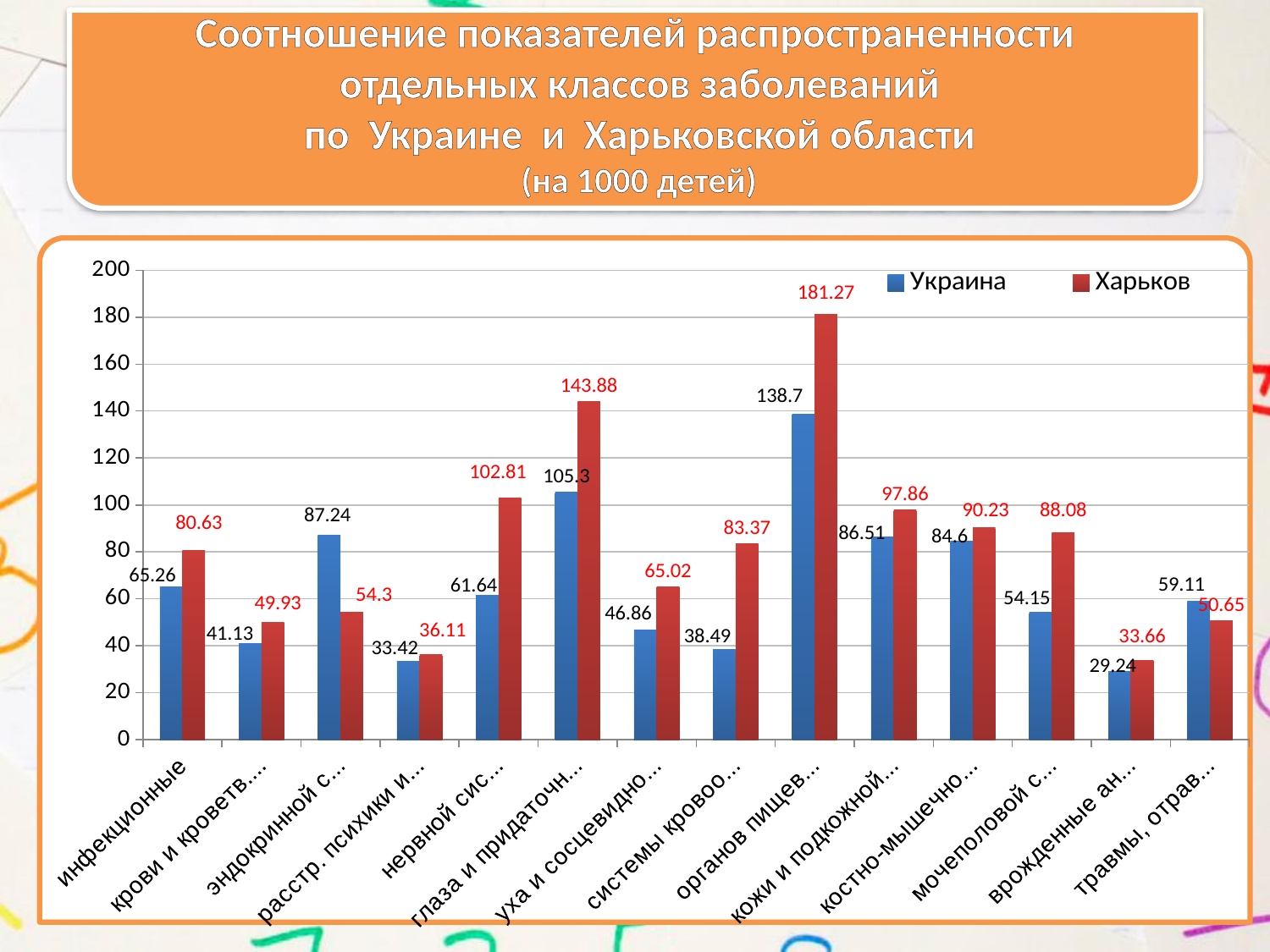
How many categories are shown on the x axis? 14 What is the value for Харьков in the травмы, отрав... category? 50.65 In the травмы, отрав... category, which series has the larger value, Украина or Харьков? Украина How many series does the legend list? 2 Which category has the lowest value for Украина? врожденные ан... In the эндокринной с... category, which series has the larger value, Украина or Харьков? Украина What kind of chart is shown on the slide? bar chart What is the value for Харьков in the инфекционные category? 80.63 Which category has the highest value for Харьков? органов пищев... What is the value for Украина in the органов пищев... category? 138.7 What is the difference between the Харьков and Украина values in the глаза и придаточн... category? 38.58 What is the difference between the Харьков and Украина values in the органов пищев... category? 42.57